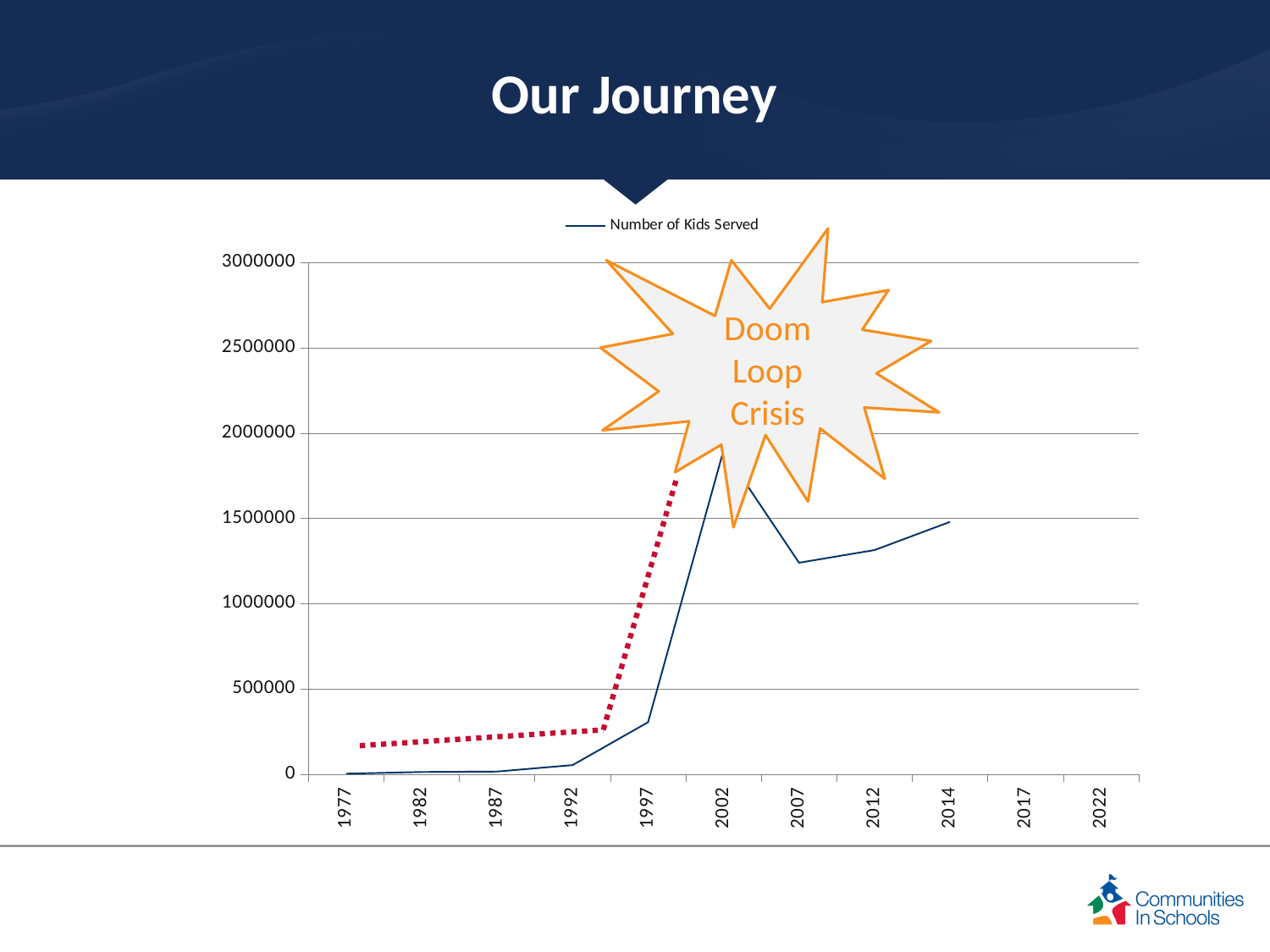
What is the name of the series shown in the legend? Number of Kids Served How many year labels are shown on the x axis? 11 In which year does the Number of Kids Served reach its highest value? 2002 In which year is the Number of Kids Served lowest? 1977 What kind of chart is shown on the slide? line chart Is the value for 1997 greater or less than 500000? less How many series does the legend list? 1 Is the value for 2002 greater or less than 1500000? greater Is the value for 2007 greater or less than 1500000? less Does the Number of Kids Served rise or fall between 1977 and 2002? rise Which year has the larger Number of Kids Served, 2002 or 2007? 2002